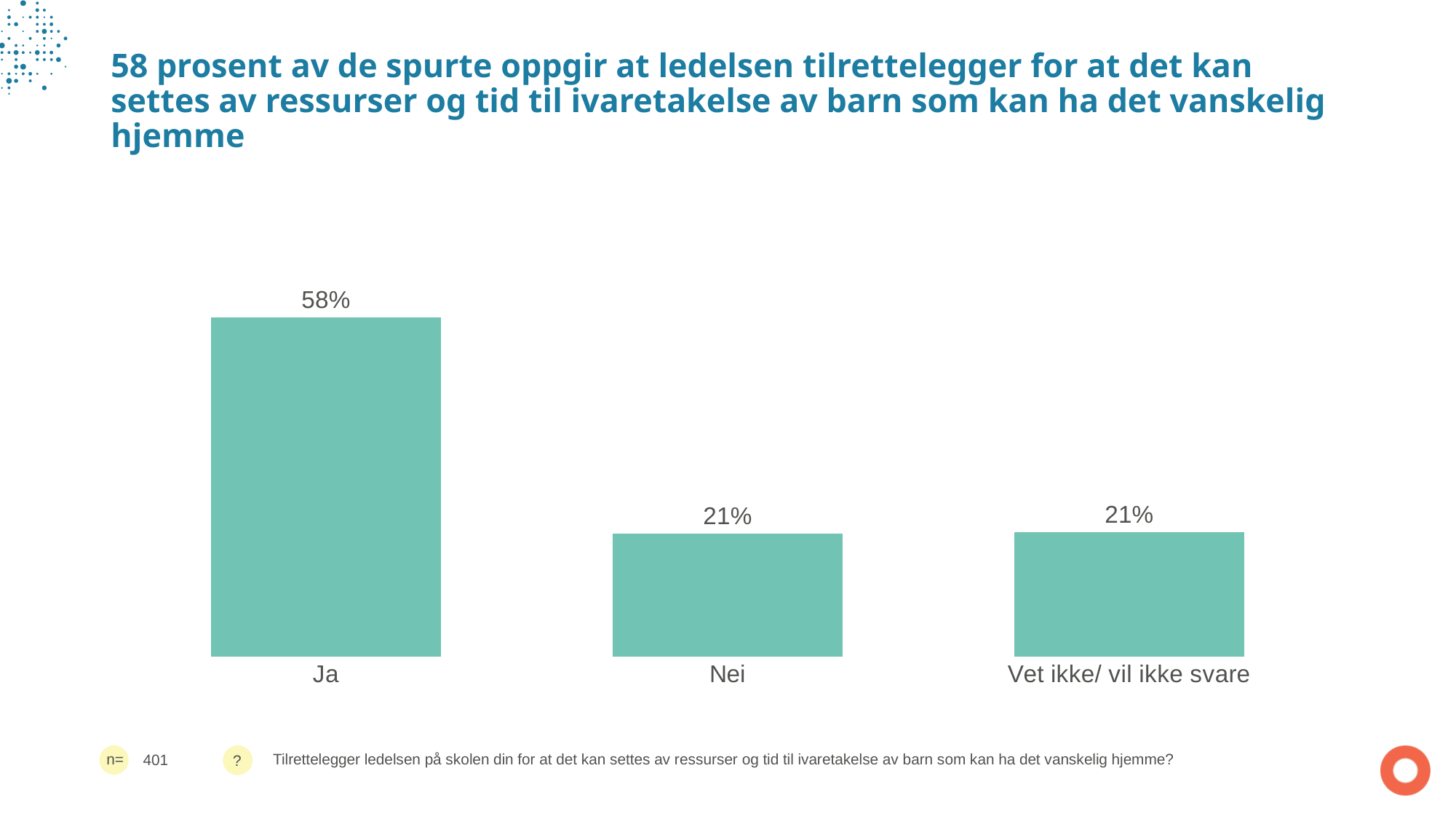
What colour are the bars in the chart? Teal/green What kind of chart is shown on the slide? Bar chart What is the value for "Vet ikke/ vil ikke svare"? 21% Which category has the highest value? Ja What is the value for "Nei"? 21% How many categories are shown in the chart? 3 What is the difference between the values for "Ja" and "Nei"? 37 percentage points Which is larger, the value for "Ja" or the value for "Vet ikke/ vil ikke svare"? Ja What is the value for "Ja"? 58% What is the total of the values for "Nei" and "Vet ikke/ vil ikke svare"? 42% What is the sample size (n) shown on the slide? 401